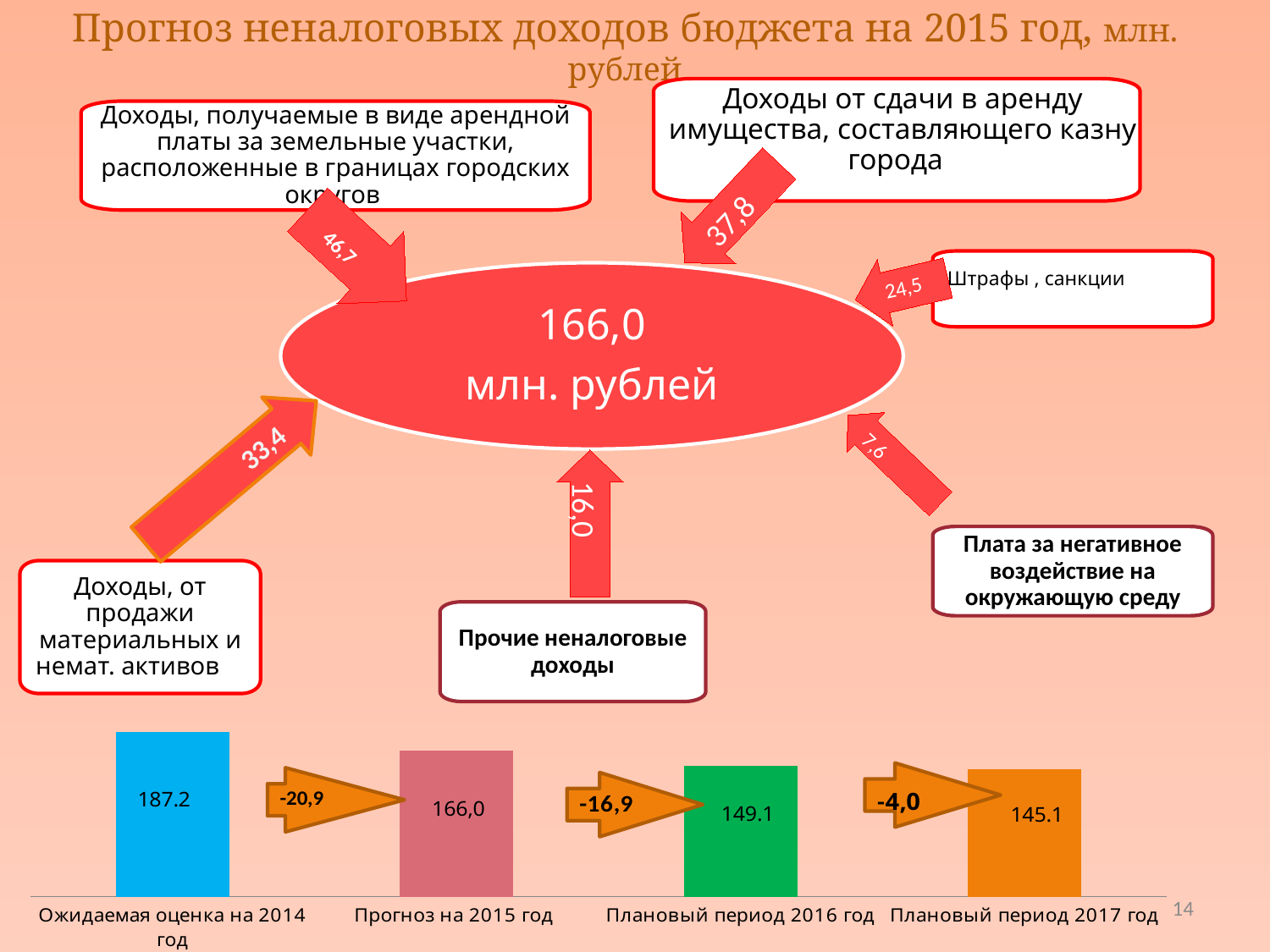
In the bar chart at the bottom, what is the value for 'Ожидаемая оценка на 2014 год'? 187.2 In the bar chart at the bottom, what is the difference between the values for 'Прогноз на 2015 год' and 'Плановый период 2016 год'? 16.9 In the bar chart at the bottom, what is the value for 'Плановый период 2017 год'? 145.1 In the bar chart at the bottom, how many bars are there? 4 In the bar chart at the bottom, which is larger: the value for 'Ожидаемая оценка на 2014 год' or 'Плановый период 2017 год'? Ожидаемая оценка на 2014 год In the bar chart at the bottom, what is the value for 'Плановый период 2016 год'? 149.1 In the bar chart at the bottom, do the values rise or fall from left to right? fall In the bar chart at the bottom, which category has the lowest value? Плановый период 2017 год In the bar chart at the bottom, which category has the highest value? Ожидаемая оценка на 2014 год In the bar chart at the bottom, what is the value for 'Прогноз на 2015 год'? 166,0 In the bar chart at the bottom, what change is written on the arrow between the 2016 and 2017 bars? -4,0 What type of chart is shown at the bottom of the slide? bar chart